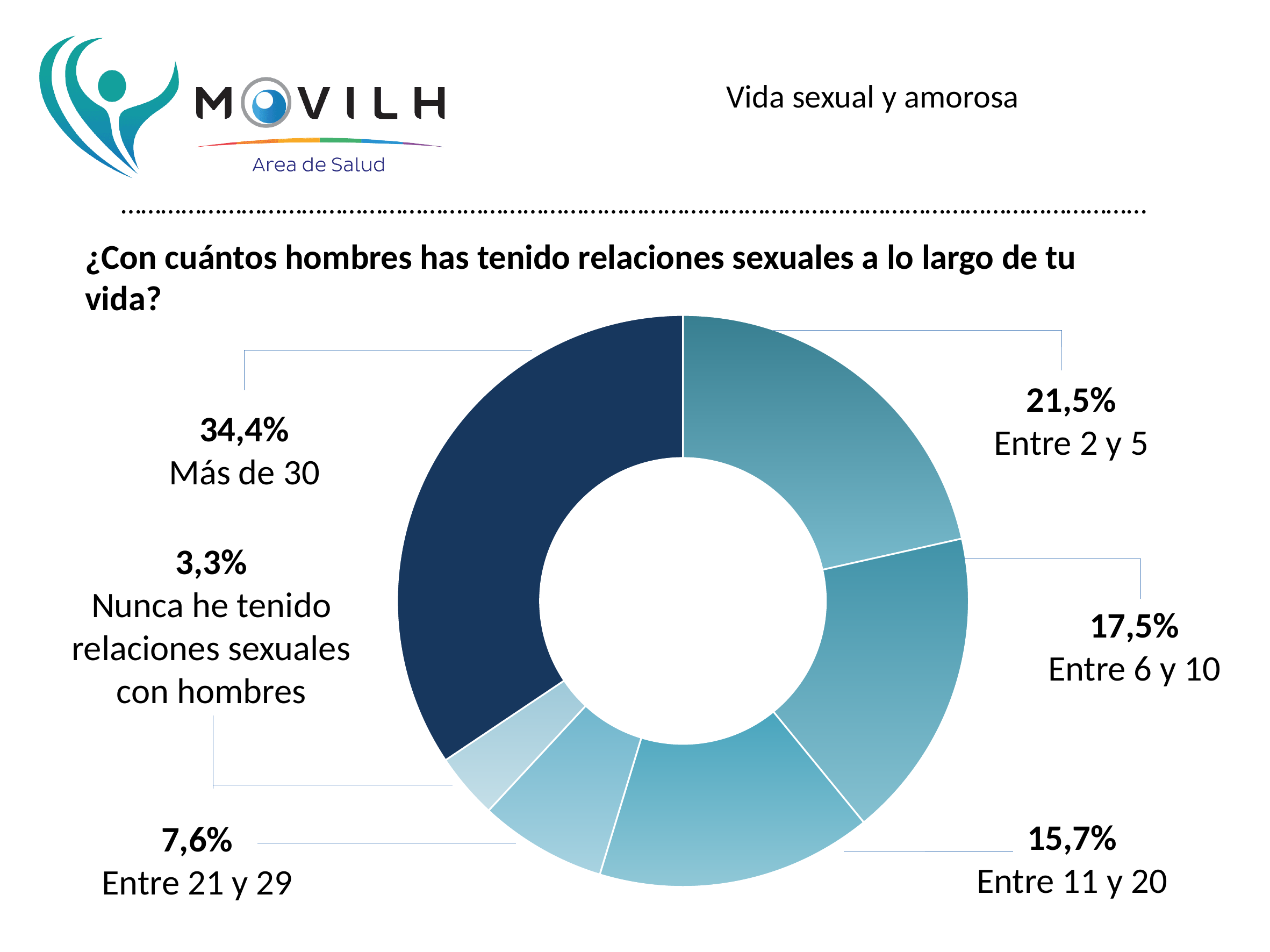
What percentage of respondents answered "Entre 2 y 5"? 21,5% What is the difference in percentage points between "Entre 2 y 5" and "Entre 6 y 10"? 4 percentage points What percentage of respondents answered "Más de 30"? 34,4% What percentage of respondents answered "Nunca he tenido relaciones sexuales con hombres"? 3,3% Which category has the smallest share of the chart? Nunca he tenido relaciones sexuales con hombres Which category has the largest share of the chart? Más de 30 Which is larger, the share for "Entre 21 y 29" or the share for "Entre 11 y 20"? Entre 11 y 20 What percentage of respondents answered "Entre 11 y 20"? 15,7% What question does the chart title ask? ¿Con cuántos hombres has tenido relaciones sexuales a lo largo de tu vida? How many categories are shown in the chart? 6 What kind of chart is shown on the slide? Pie chart (donut) What is the combined share of "Entre 2 y 5" and "Entre 6 y 10"? 39%